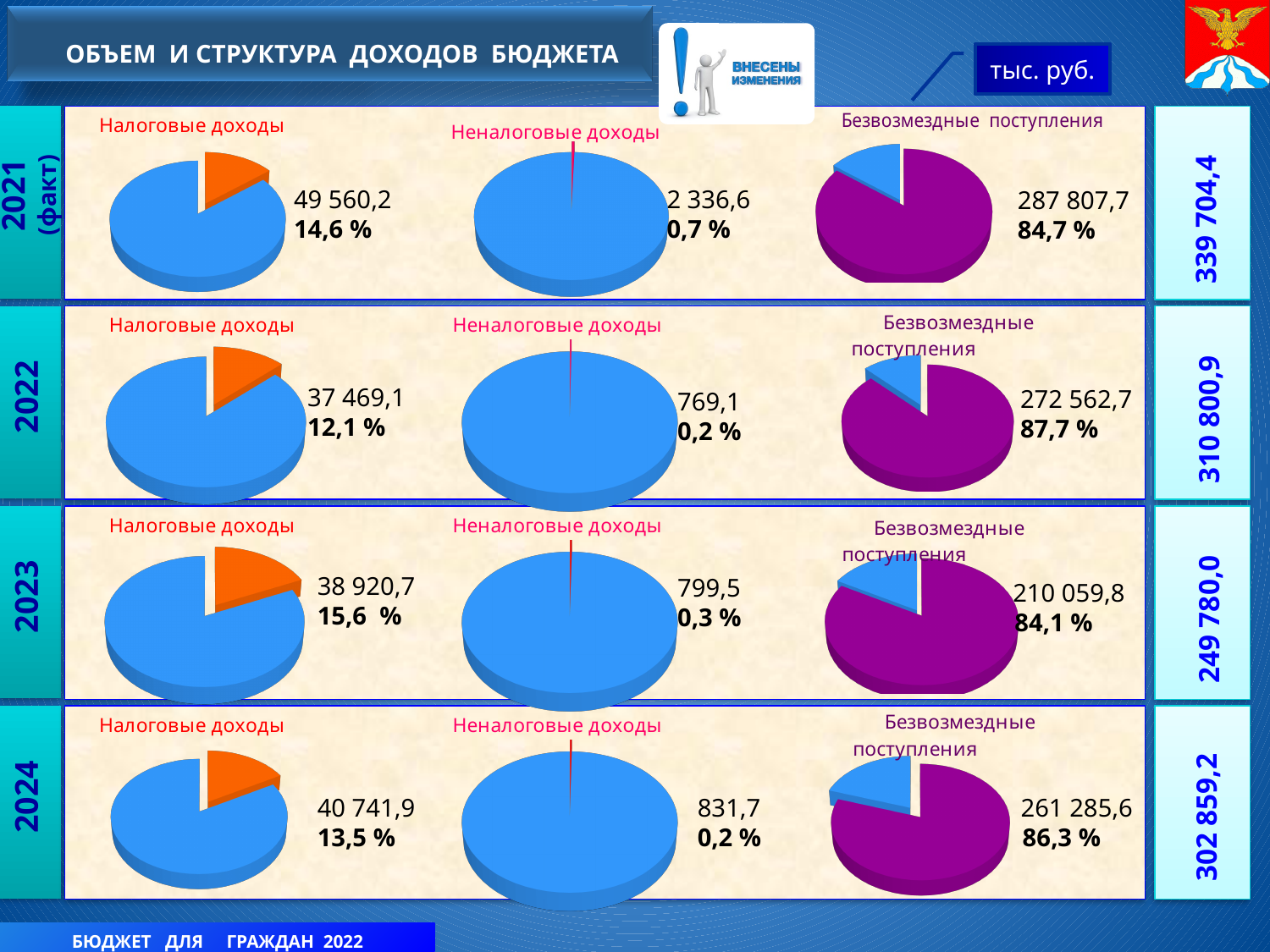
What kind of charts are shown on the slide? Pie charts In the 2021 (факт) row, what percentage is shown on the Безвозмездные поступления pie chart? 84,7 % Across the four rows, which year's Неналоговые доходы pie chart shows the lowest value? 2022 What is the difference between the Налоговые доходы value in the 2024 row and the Налоговые доходы value in the 2023 row? 1 821,2 In the 2023 row, what percentage is shown on the Налоговые доходы pie chart? 15,6 % In the 2022 row, what value is shown on the Неналоговые доходы pie chart? 769,1 Across the four rows, which year's Безвозмездные поступления pie chart shows the highest percentage? 2022 In the 2024 row, what value is shown on the Безвозмездные поступления pie chart? 261 285,6 What total is shown at the right of the 2023 row? 249 780,0 In the 2021 (факт) row, what value is shown on the Налоговые доходы pie chart? 49 560,2 In the 2022 row, which pie chart shows the larger value: Налоговые доходы or Неналоговые доходы? Налоговые доходы How many pie charts are shown on the slide? 12